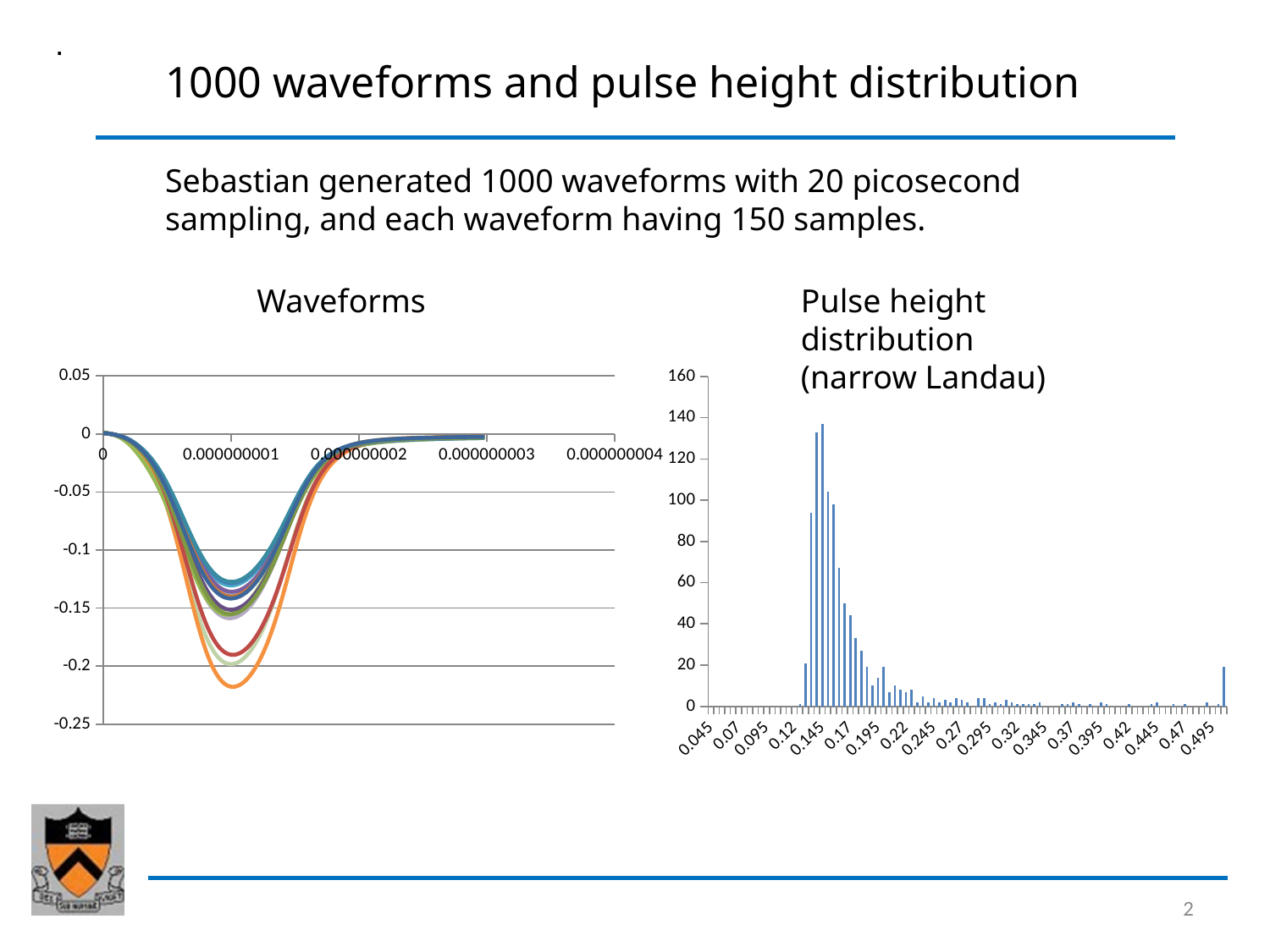
What is the highest value shown on the y axis of the Pulse height distribution chart? 160 What kind of chart is the Pulse height distribution chart on the right? bar chart In the Pulse height distribution chart, do the bar heights generally rise or fall as the x axis moves from 0.17 toward 0.495? fall In the Waveforms chart, do the waveforms first fall or first rise as the x axis increases from 0? fall In the Pulse height distribution chart, is the bar at 0.045 greater or less than 20? less In the Pulse height distribution chart, is the tallest bar greater or less than 120? greater What is the lowest value shown on the y axis of the Waveforms chart? -0.25 In the Waveforms chart, is the lowest value reached by any waveform greater or less than -0.2? less What kind of chart is the Waveforms chart on the left? line chart